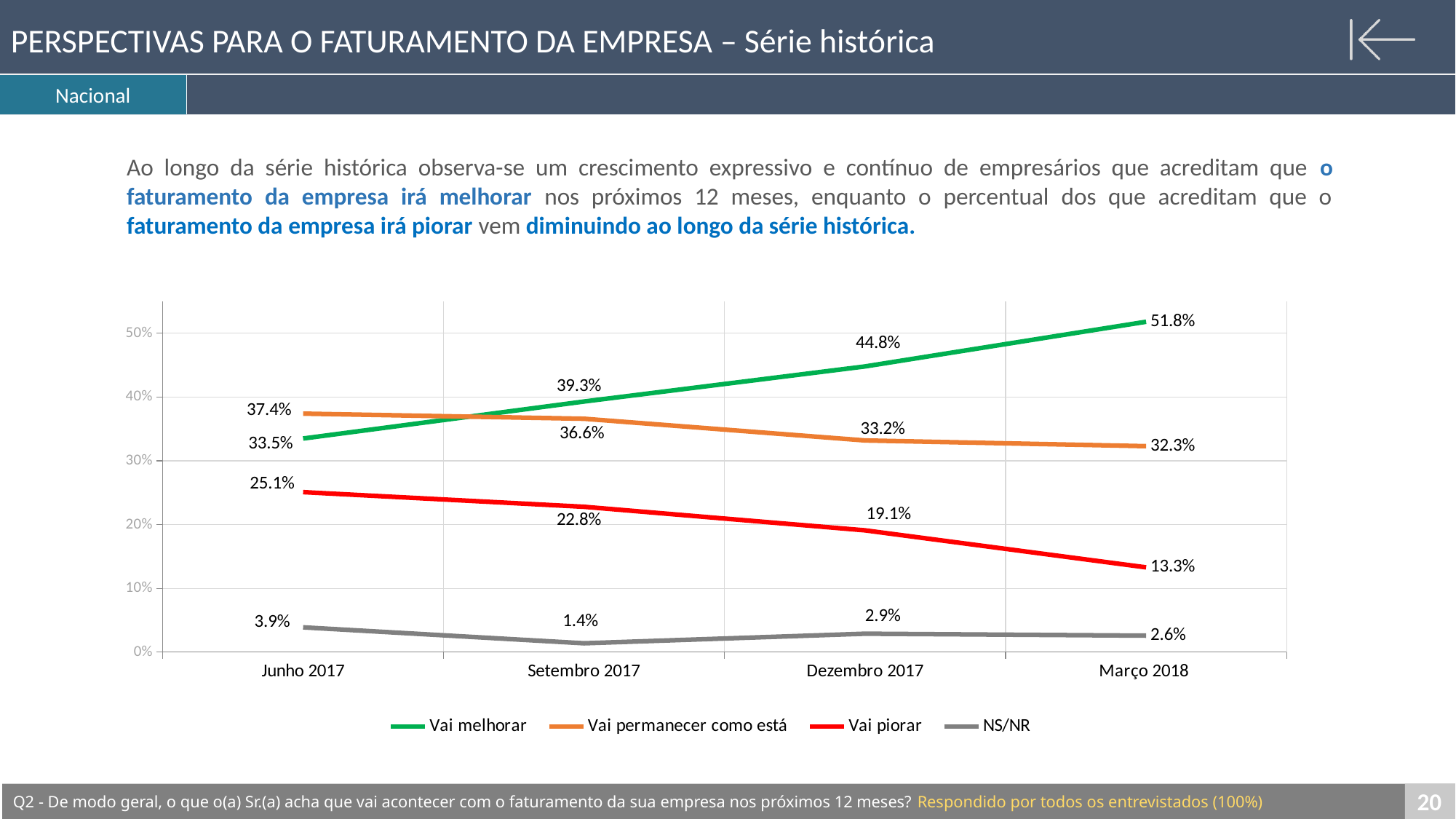
Which series has the higher value in Junho 2017: "Vai melhorar" or "Vai permanecer como está"? Vai permanecer como está What type of chart is shown on the slide? line chart What is the value for "Vai melhorar" in Março 2018? 51.8% What is the value for "Vai piorar" in Setembro 2017? 22.8% How many time points are plotted along the x axis? 4 What is the value for "NS/NR" in Junho 2017? 3.9% In which period does "NS/NR" have its lowest value? Setembro 2017 What is the difference between "Vai melhorar" in Março 2018 and in Junho 2017? 18.3% How many series does the legend list? 4 Does the "Vai piorar" series rise or fall from Junho 2017 to Março 2018? fall What is the value for "Vai permanecer como está" in Dezembro 2017? 33.2% In which period does "Vai melhorar" reach its highest value? Março 2018